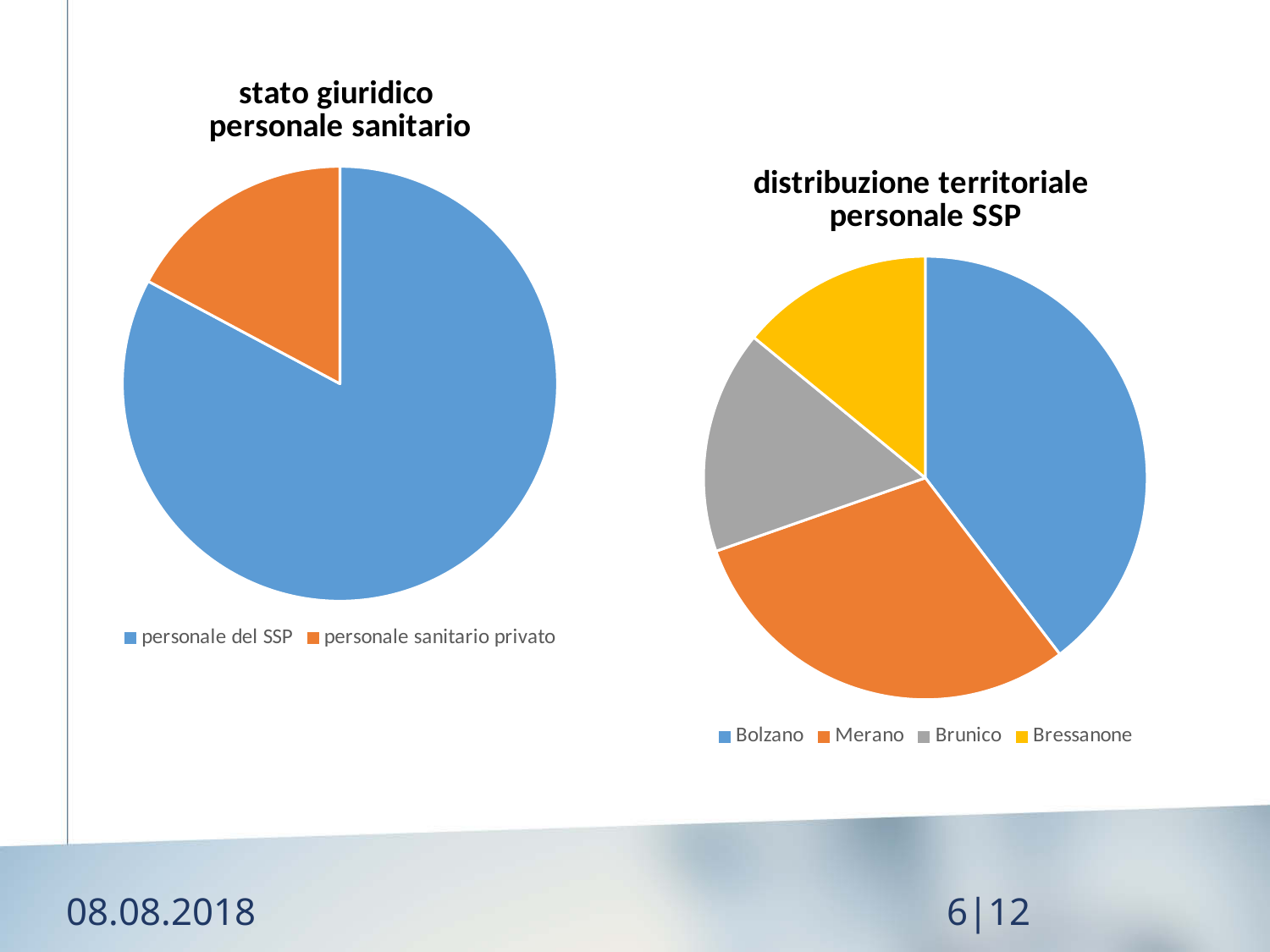
In the chart titled "distribuzione territoriale personale SSP", which category has the largest slice? Bolzano In the chart titled "stato giuridico personale sanitario", which category has the largest slice? personale del SSP In the chart titled "stato giuridico personale sanitario", how many entries does the legend list? 2 What kind of chart is the chart titled "stato giuridico personale sanitario"? pie chart In the chart titled "distribuzione territoriale personale SSP", which slice is larger, Merano or Brunico? Merano In the chart titled "stato giuridico personale sanitario", how many slices does the pie have? 2 In the chart titled "distribuzione territoriale personale SSP", how many slices does the pie have? 4 In the chart titled "stato giuridico personale sanitario", which category has the smallest slice? personale sanitario privato What kind of chart is the chart titled "distribuzione territoriale personale SSP"? pie chart In the chart titled "distribuzione territoriale personale SSP", what colour is the Bressanone slice? yellow In the chart titled "distribuzione territoriale personale SSP", how many entries does the legend list? 4 In the chart titled "distribuzione territoriale personale SSP", which slice is larger, Bolzano or Merano? Bolzano